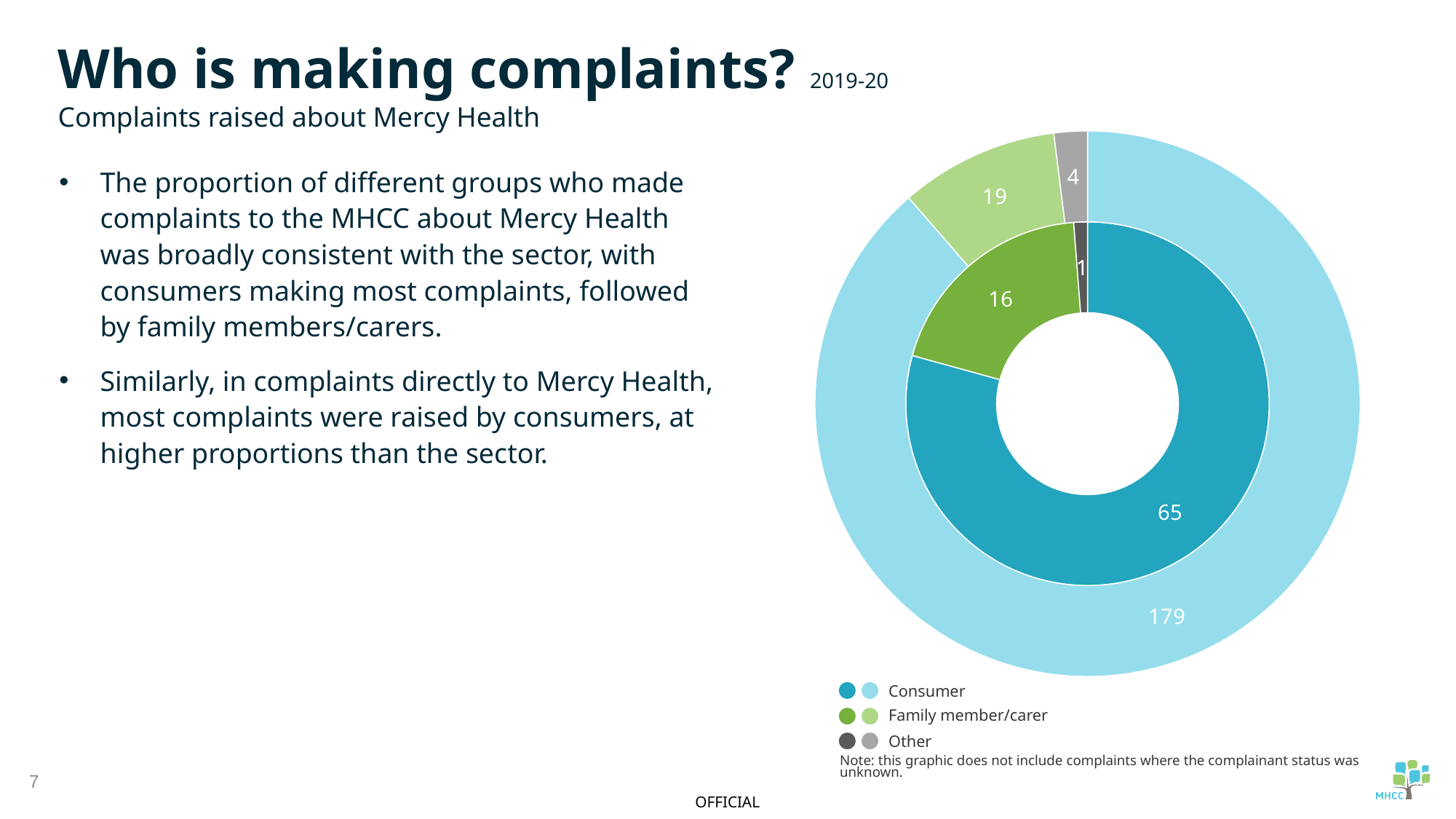
Which category has the largest value in the outer ring of the doughnut chart? Consumer Which legend entry is shown in grey in the doughnut chart? Other What is the value for Consumer in the outer ring of the doughnut chart? 179 What is the value for Family member/carer in the outer ring of the doughnut chart? 19 What is the difference between the Consumer and Family member/carer values in the inner ring of the doughnut chart? 49 What kind of chart is shown on the slide? Doughnut chart How many categories does the legend of the doughnut chart list? 3 What is the value for Consumer in the inner ring of the doughnut chart? 65 In the outer ring of the doughnut chart, is the value for Family member/carer larger or smaller than the value for Other? Larger What is the value for Other in the inner ring of the doughnut chart? 1 Which category has the smallest value in the inner ring of the doughnut chart? Other What is the total of the values shown in the outer ring of the doughnut chart? 202